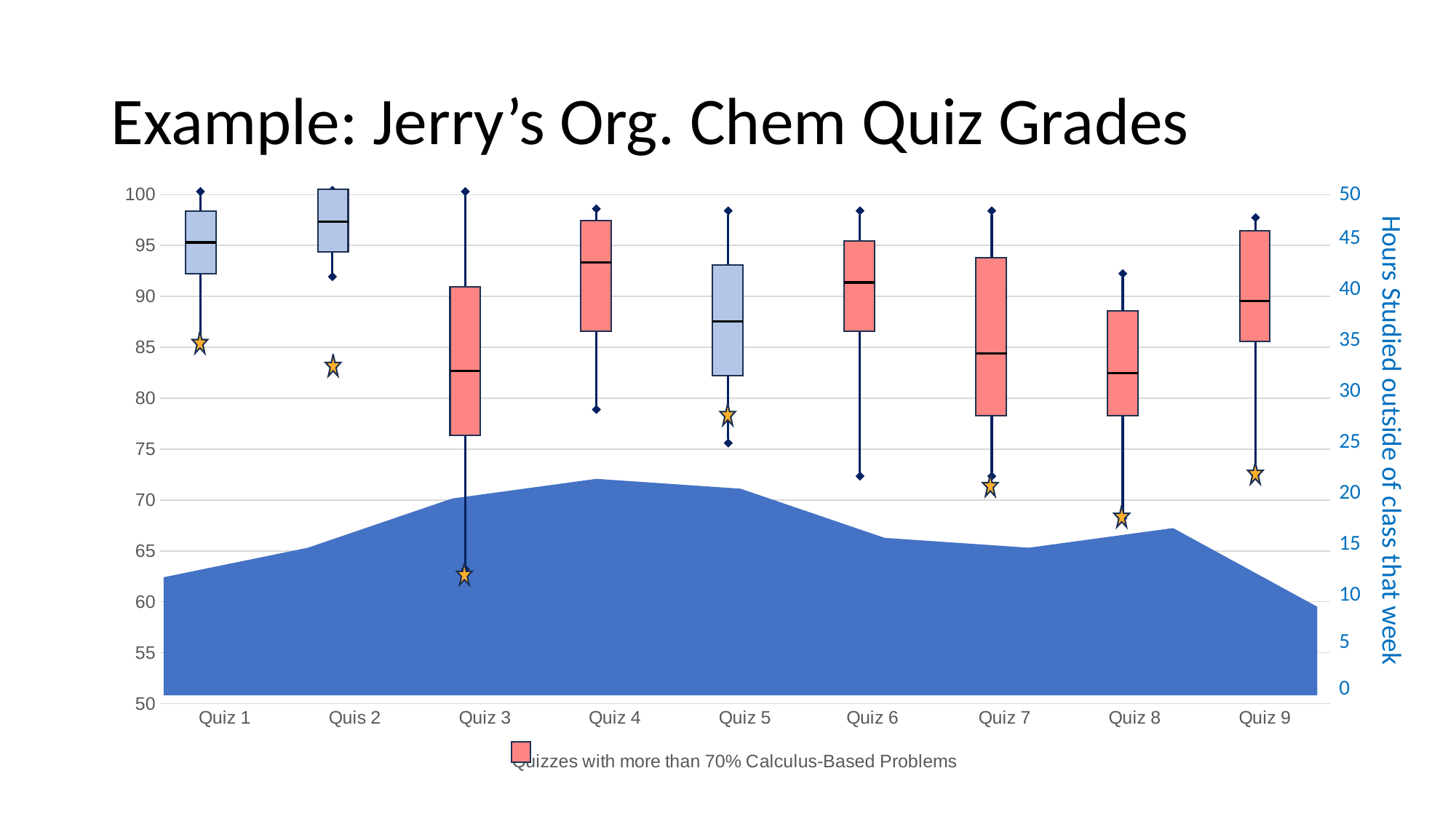
What is the title of the right-hand vertical axis? Hours Studied outside of class that week Do the hours studied rise or fall from Quiz 1 to Quiz 4? rise Is the star marker for Quiz 3 greater or less than 65 on the grade axis? less How many quizzes are shown along the x axis? 9 Which quiz has the highest median grade? Quis 2 Is the median grade for Quiz 3 greater or less than 85? less Which quiz week has the lowest hours studied outside of class? Quiz 9 What does the legend say the red boxes represent? Quizzes with more than 70% Calculus-Based Problems Is the star marker for Quiz 1 greater or less than 80 on the grade axis? greater What kind of chart is this? Box plot combined with an area chart How many quizzes are drawn with red boxes? 6 Which quiz week has the highest hours studied outside of class? Quiz 4